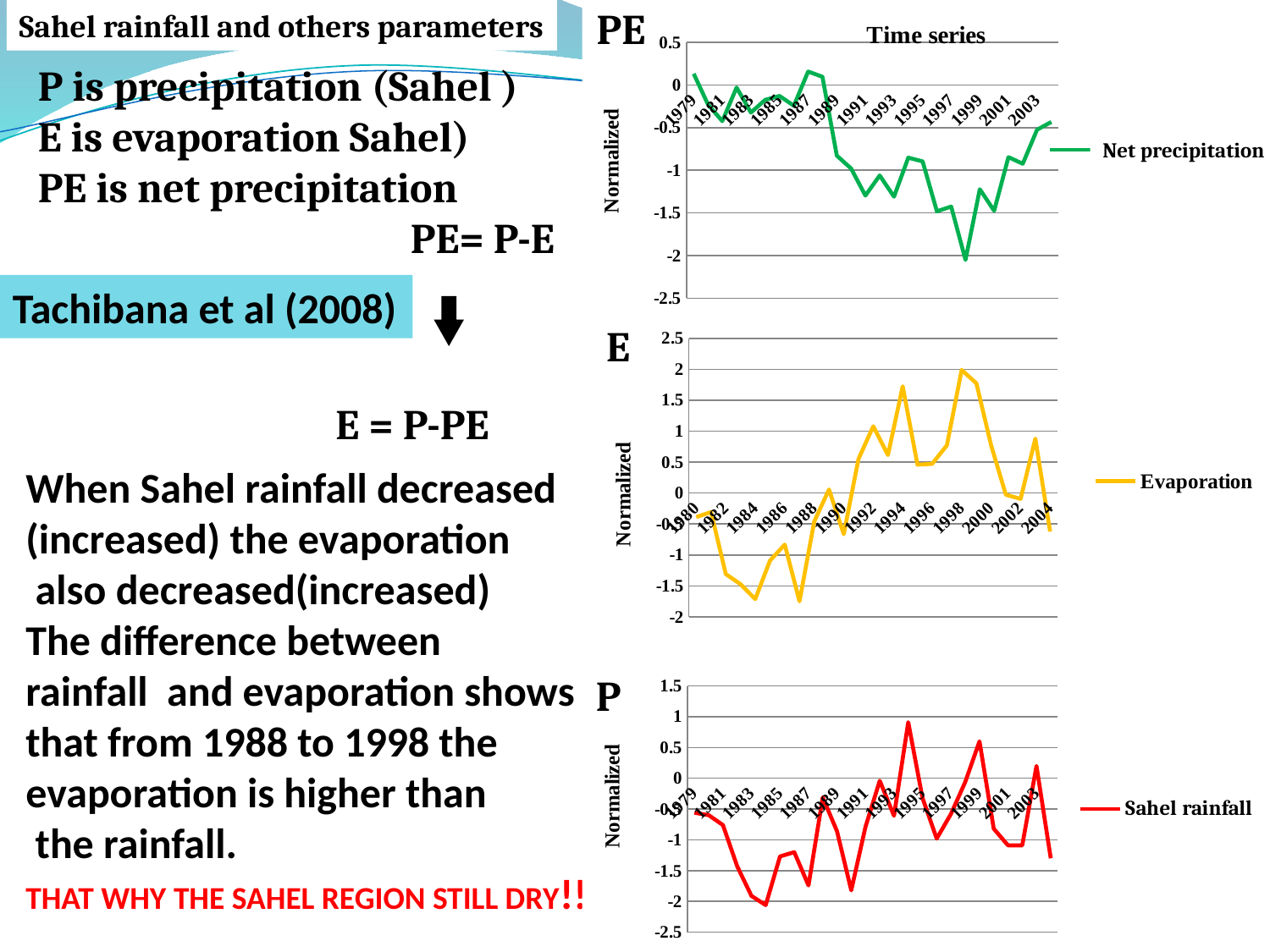
In the bottom chart labelled P, which year has the highest Sahel rainfall value? 1994 What kind of chart is the top chart labelled PE? line chart In the middle chart labelled E, which year has the highest evaporation value? 1998 In the bottom chart labelled P, is the Sahel rainfall value for 1984 greater or less than -1.5? less In the bottom chart labelled P, which year has the lowest Sahel rainfall value? 1984 In the top chart labelled PE, which year has the lowest net precipitation value? 1998 What is the title of the top chart labelled PE? Time series What is the legend entry of the bottom chart labelled P? Sahel rainfall In the middle chart labelled E, is the evaporation value for 1998 greater or less than 1.5? greater In the top chart labelled PE, is the net precipitation value for 1999 greater or less than -1.5? greater In the middle chart labelled E, do the evaporation values generally rise or fall from 1984 to 1998? rise How many series does the legend of the middle chart labelled E list? 1